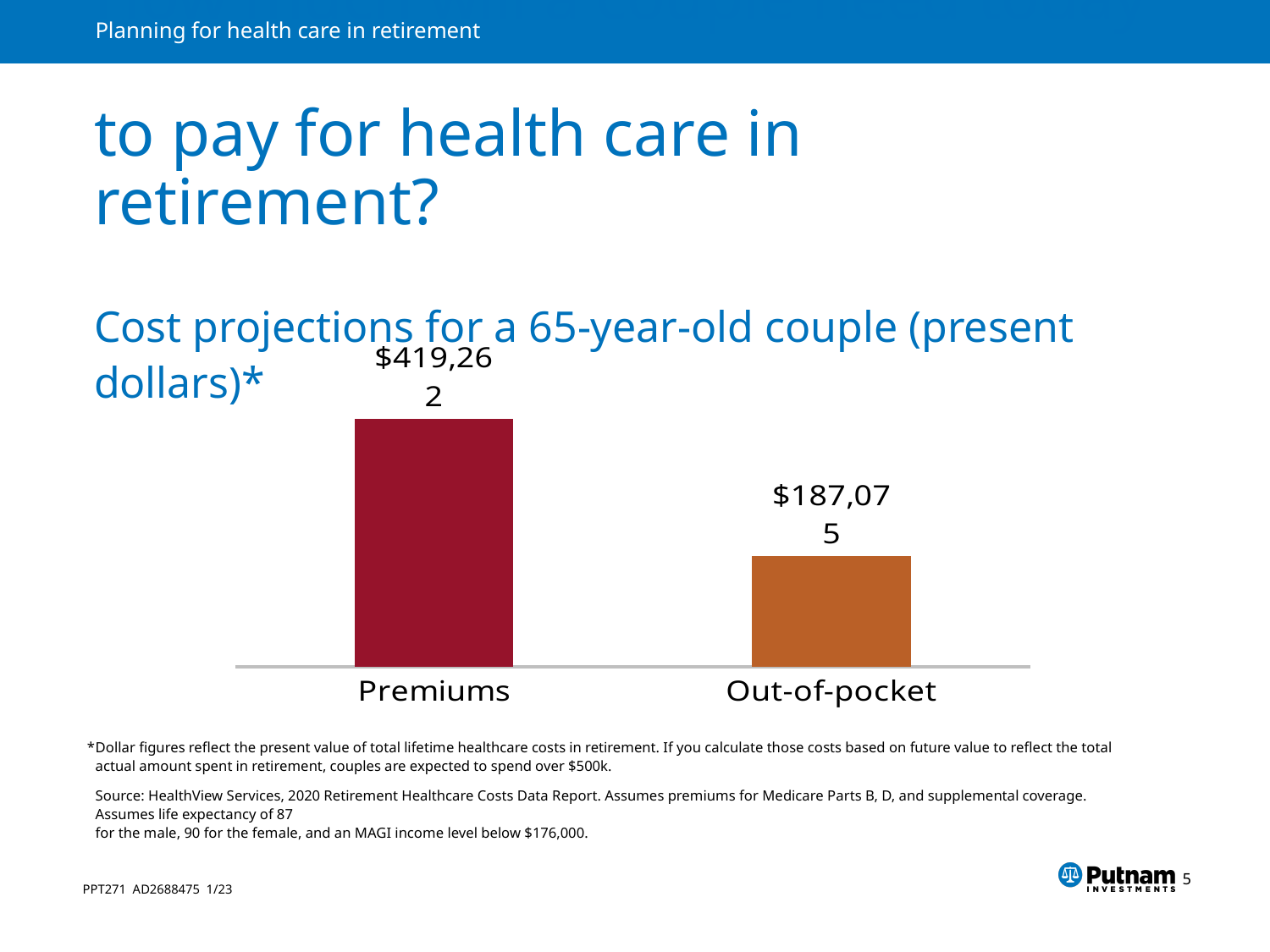
What is the combined total of the Premiums and Out-of-pocket values? $606,337 Which category has the highest value? Premiums What kind of chart is shown on the slide? Bar chart What is the difference between the Premiums value and the Out-of-pocket value? $232,187 Which is larger, Premiums or Out-of-pocket? Premiums Which category has the lowest value? Out-of-pocket How many categories are shown in the chart? 2 What is the value for Out-of-pocket? $187,075 What is the value for Premiums? $419,262 What is the title of the chart? Cost projections for a 65-year-old couple (present dollars)* What colour is the Out-of-pocket bar? Orange